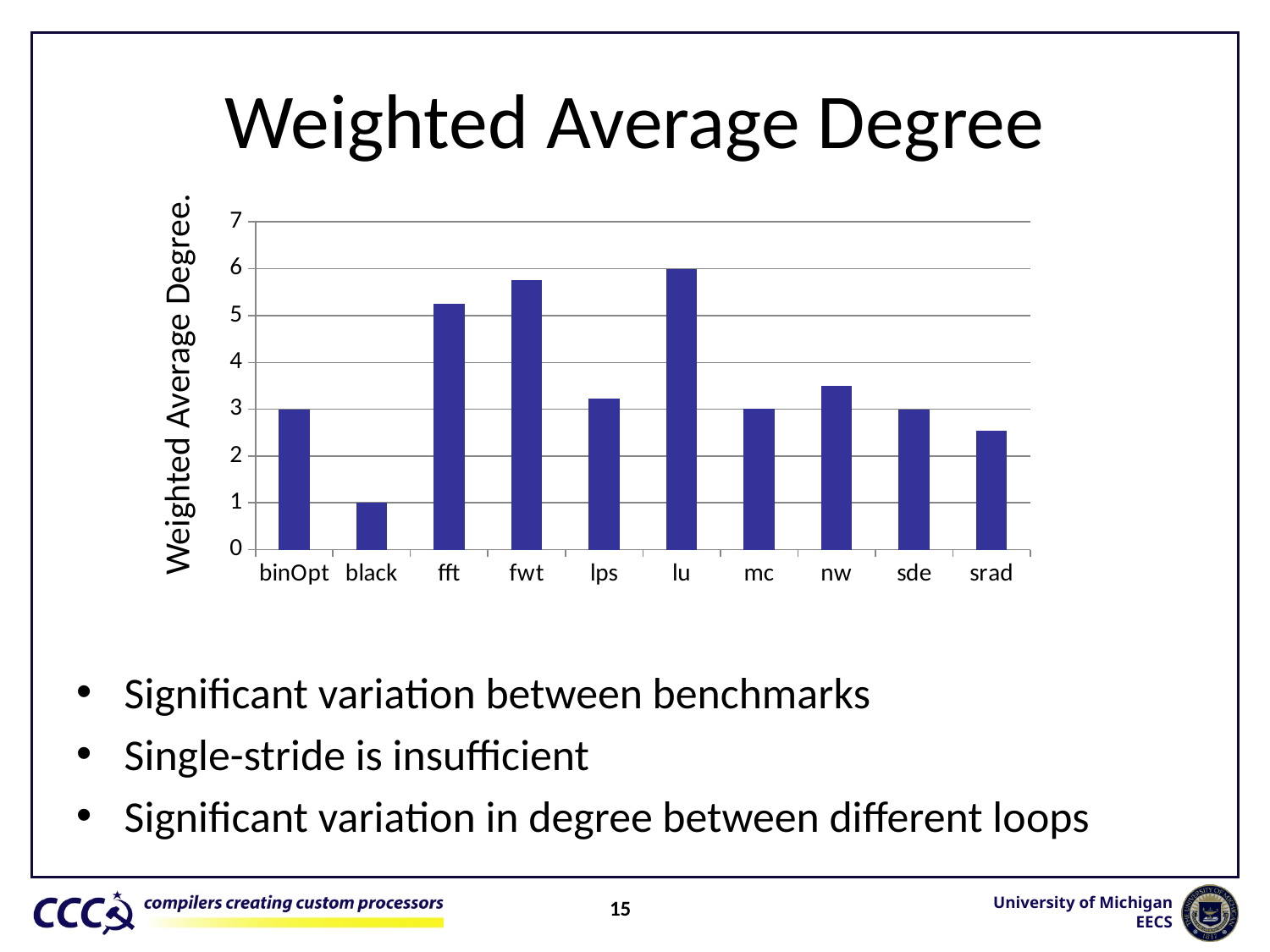
What is the title of the chart? Weighted Average Degree Is the value for srad greater or less than 3? less What is the weighted average degree for black? 1 Which benchmark has the lowest weighted average degree? black What is the weighted average degree for binOpt? 3 Is the value for fwt greater or less than 5? greater What kind of chart is shown on the slide? bar chart How many benchmarks are shown on the x axis? 10 Which benchmark has the highest weighted average degree? lu What is the weighted average degree for lu? 6 What is the difference between the weighted average degree of lu and black? 5 Which has a larger weighted average degree, fft or nw? fft